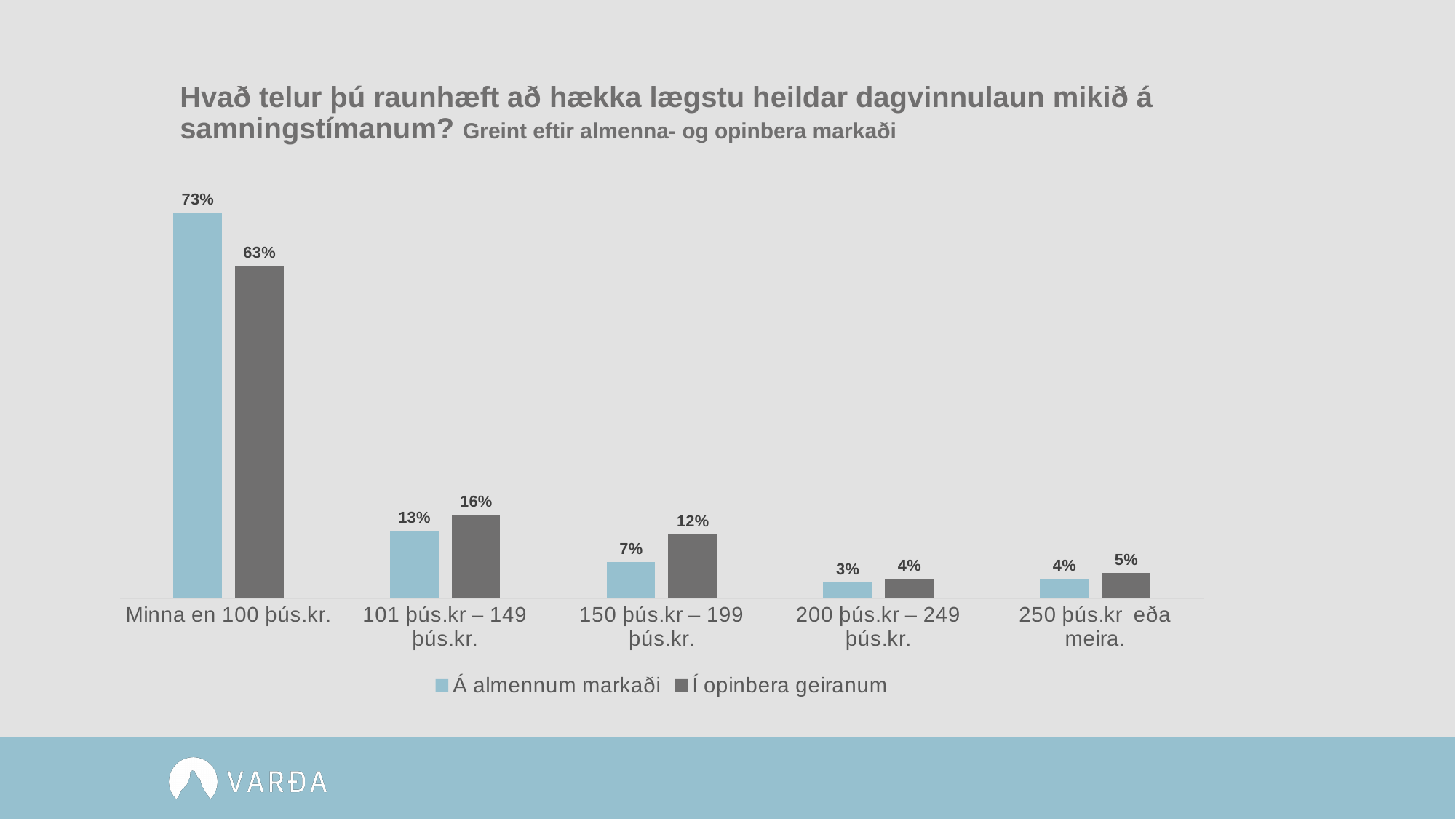
What is the value for "Í opinbera geiranum" in the "250 þús.kr eða meira." category? 5% How many categories are shown on the x axis? 5 In the "150 þús.kr – 199 þús.kr." category, which series has the larger value? Í opinbera geiranum What is the difference between the "Á almennum markaði" and "Í opinbera geiranum" values in the "Minna en 100 þús.kr." category? 10% Which colour represents the "Á almennum markaði" series? Light blue What is the value for "Á almennum markaði" in the "Minna en 100 þús.kr." category? 73% Which category has the lowest value for "Á almennum markaði"? 200 þús.kr – 249 þús.kr. What is the value for "Í opinbera geiranum" in the "101 þús.kr – 149 þús.kr." category? 16% How many series does the legend list? 2 Which category has the highest value for "Í opinbera geiranum"? Minna en 100 þús.kr. What is the value for "Á almennum markaði" in the "150 þús.kr – 199 þús.kr." category? 7% What kind of chart is shown on the slide? Bar chart